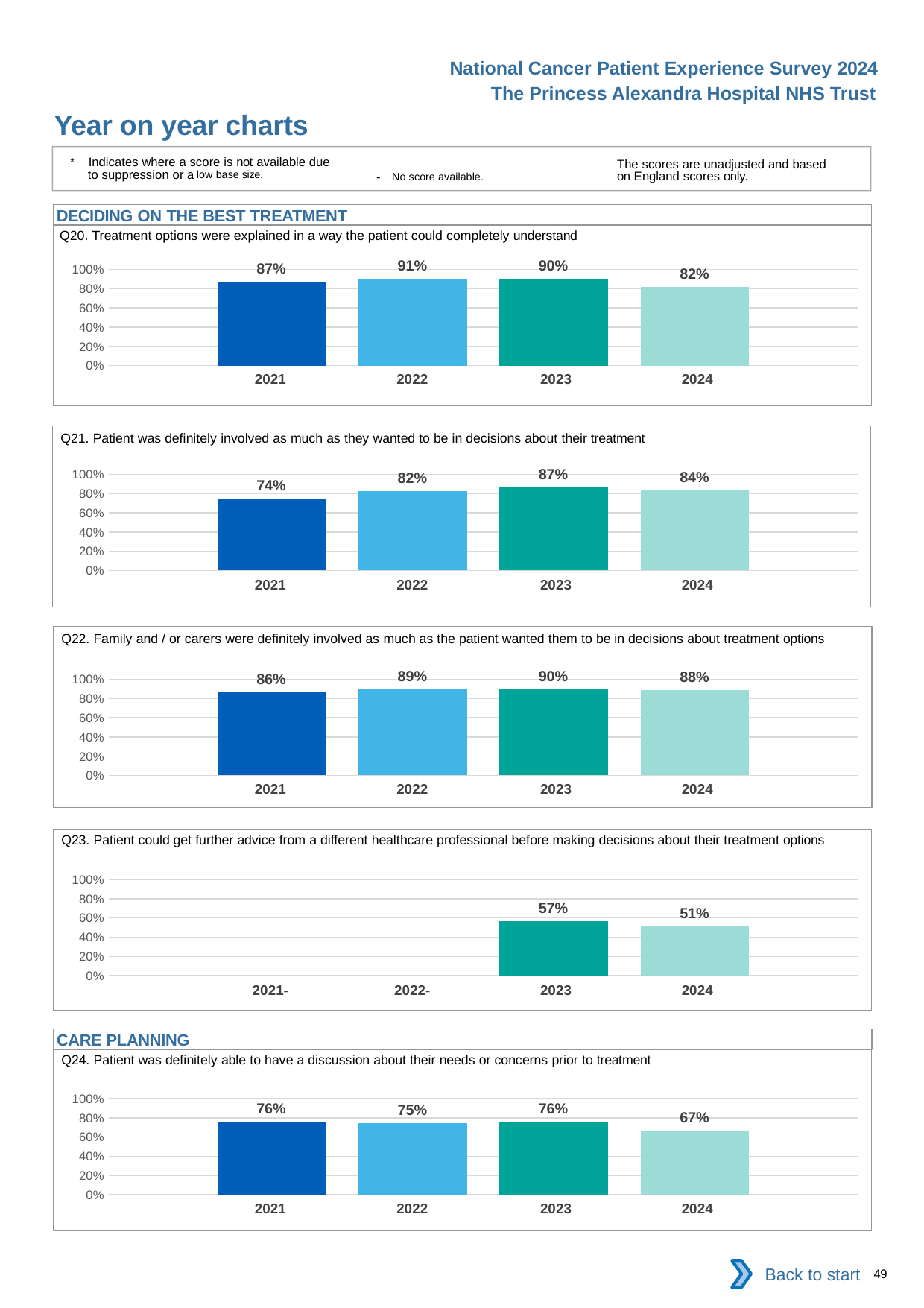
In the Q22 chart, what is the value for 2024? 88% In the Q22 chart, is the value for 2022 larger or smaller than the value for 2021? larger In the Q24 chart, what is the difference between the 2023 and 2024 values? 9% In the Q21 chart, which year has the highest value? 2023 In the Q20 chart, what is the value for 2022? 91% In the Q21 chart, what is the difference between the 2023 and 2021 values? 13% What kind of chart is used for Q20? Bar chart In the Q20 chart, which year has the lowest value? 2024 In the Q23 chart, what is the value for 2023? 57% In the Q23 chart, how many years have a bar plotted? 2 In the Q24 chart, which year has the lowest value? 2024 In the Q23 chart, is the value for 2024 greater or less than 60%? less